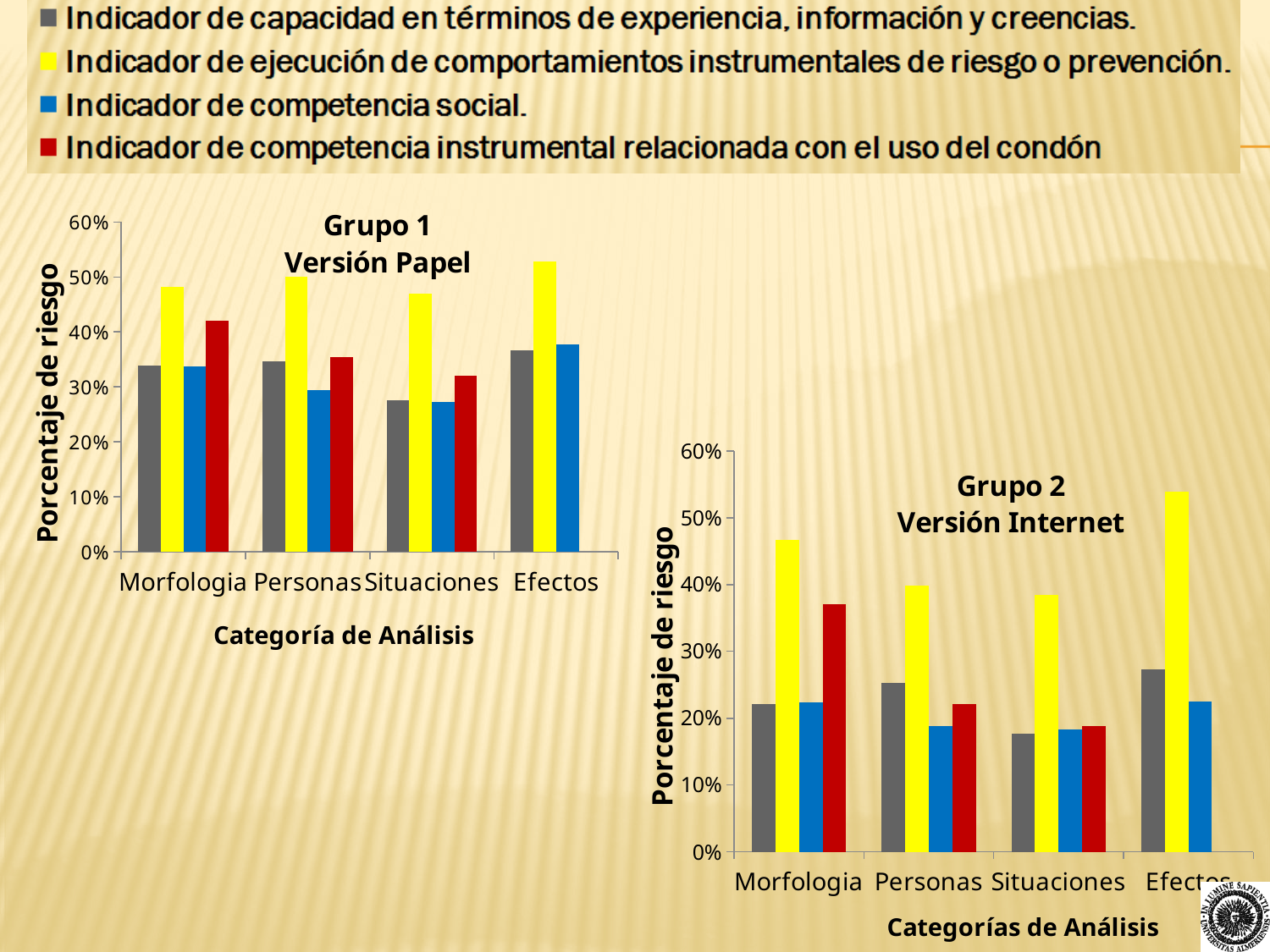
In the Grupo 2 Versión Internet chart, is the value of the yellow bar for Morfologia greater or less than 40%? greater What is the y-axis title of the Grupo 1 Versión Papel chart? Porcentaje de riesgo How many series does the legend at the top of the slide list? 4 In the Grupo 2 Versión Internet chart, is the value of the gray bar for Situaciones greater or less than 20%? less In the Grupo 1 Versión Papel chart, is the value of the yellow bar (Indicador de ejecución de comportamientos instrumentales de riesgo o prevención) for Efectos greater or less than 50%? greater In the Grupo 2 Versión Internet chart, which category has the highest yellow bar? Efectos In the Grupo 2 Versión Internet chart, which category has the lowest gray bar (Indicador de capacidad en términos de experiencia, información y creencias)? Situaciones In the Grupo 2 Versión Internet chart, for Morfologia, which is larger: the red bar (Indicador de competencia instrumental relacionada con el uso del condón) or the blue bar (Indicador de competencia social)? the red bar How many categories are shown on the x axis of the Grupo 2 Versión Internet chart? 4 In the Grupo 1 Versión Papel chart, which category has the highest yellow bar? Efectos What kind of chart is the Grupo 1 Versión Papel chart? bar chart